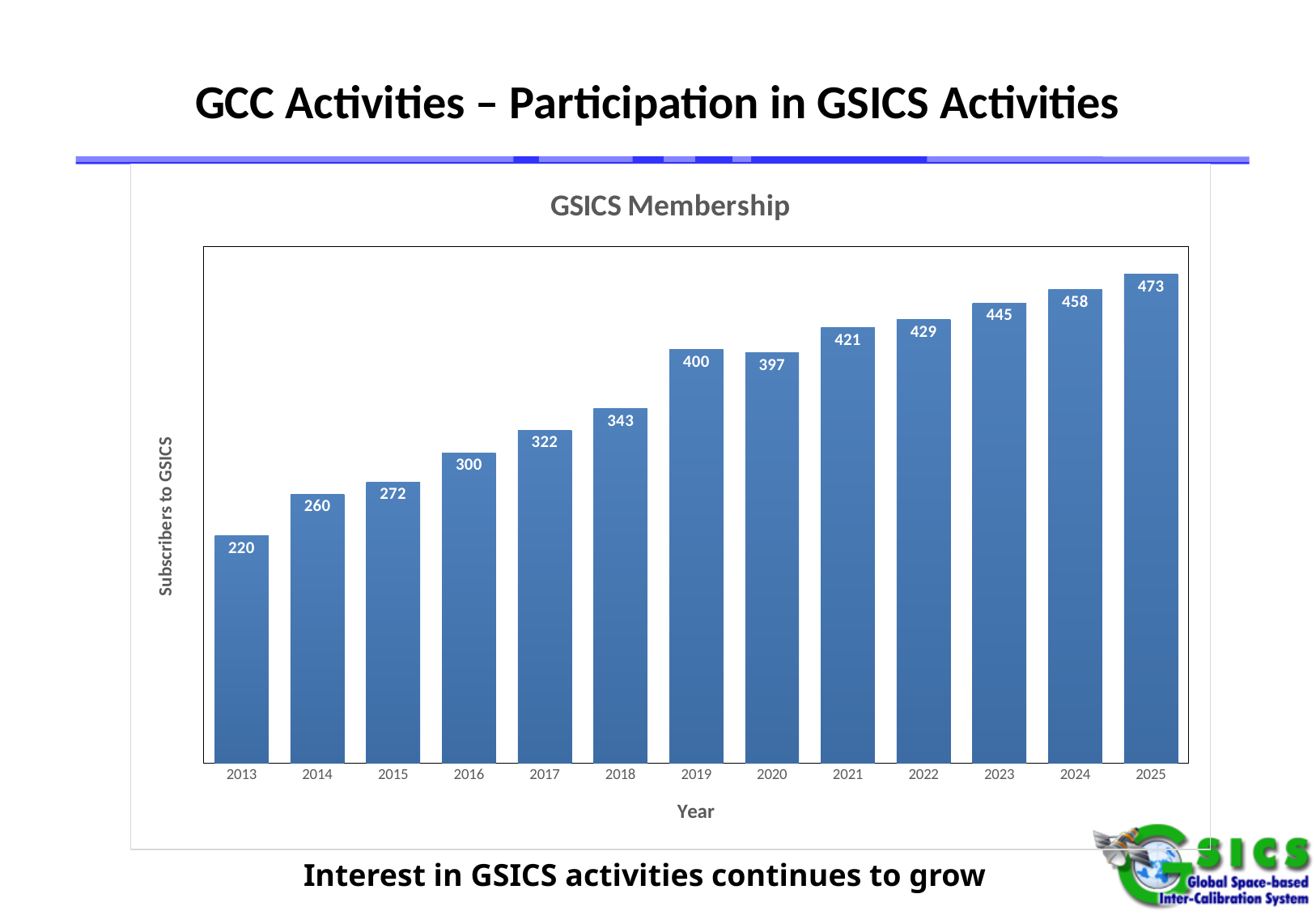
Do the subscriber numbers generally rise or fall from 2013 to 2025? Rise What is the difference in subscribers between 2025 and 2013? 253 What is the difference in subscribers between 2019 and 2020? 3 What is the number of subscribers to GSICS in 2025? 473 What is the number of subscribers to GSICS in 2013? 220 Which year has the highest number of subscribers to GSICS? 2025 How many years are shown on the x axis of the chart? 13 What is the number of subscribers to GSICS in 2019? 400 What is the title of the chart? GSICS Membership Which year has the lowest number of subscribers to GSICS? 2013 Which year has more subscribers, 2019 or 2020? 2019 What kind of chart is shown on the slide? Bar chart